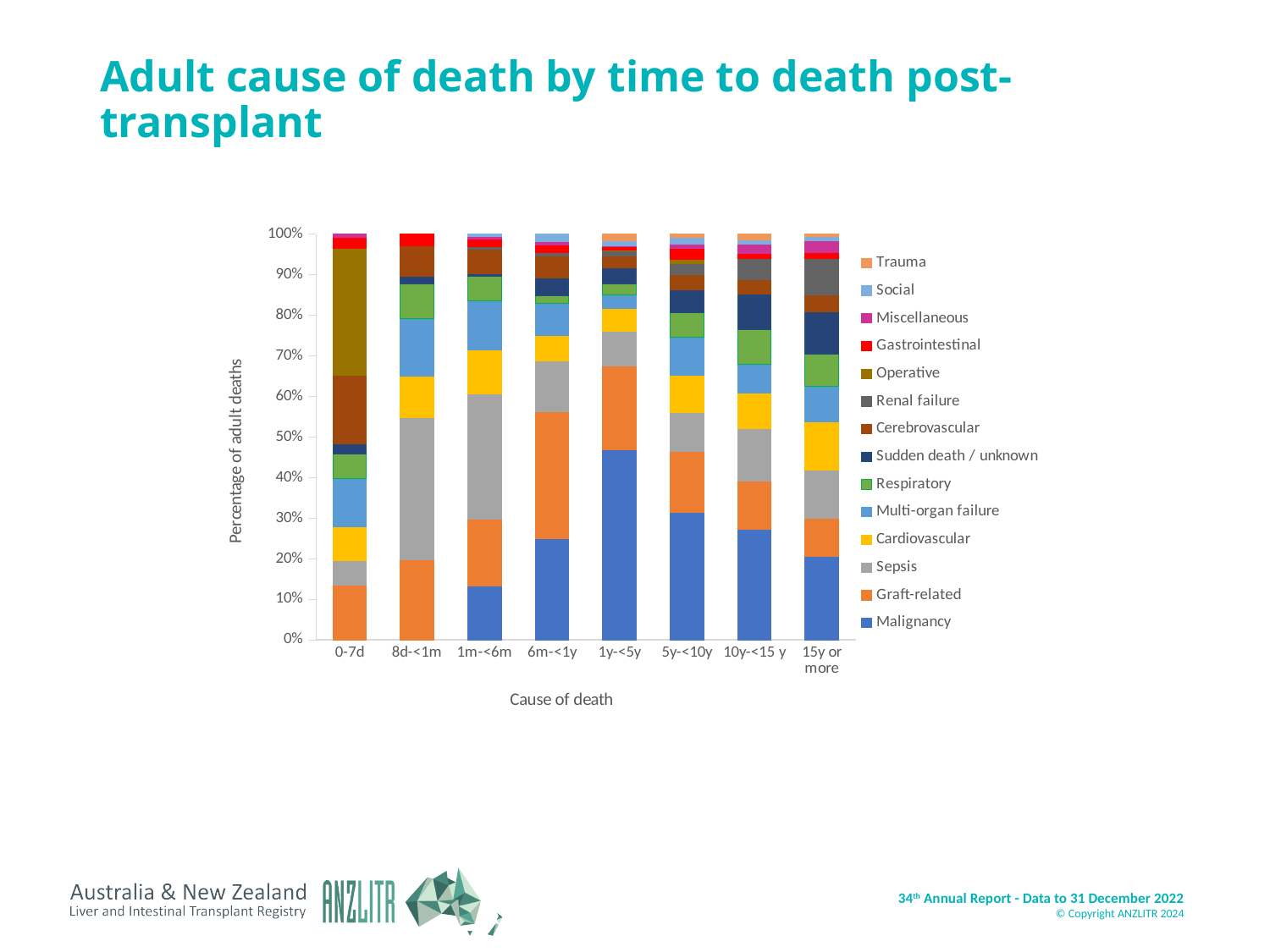
How many time-to-death categories are shown on the x axis? 8 What kind of chart is shown on the slide? Stacked bar chart What is the title of the vertical axis? Percentage of adult deaths Is the Operative share for 0-7d greater or less than 20%? greater Is the Malignancy share for 1y-<5y greater or less than 40%? greater Which has the larger Graft-related share, 0-7d or 8d-<1m? 8d-<1m Is the Malignancy share for 15y or more greater or less than 30%? less Which has the larger Malignancy share, 1y-<5y or 5y-<10y? 1y-<5y Which time category has the largest Graft-related share? 6m-<1y How many causes of death does the legend list? 14 Which time category has the largest Malignancy share? 1y-<5y